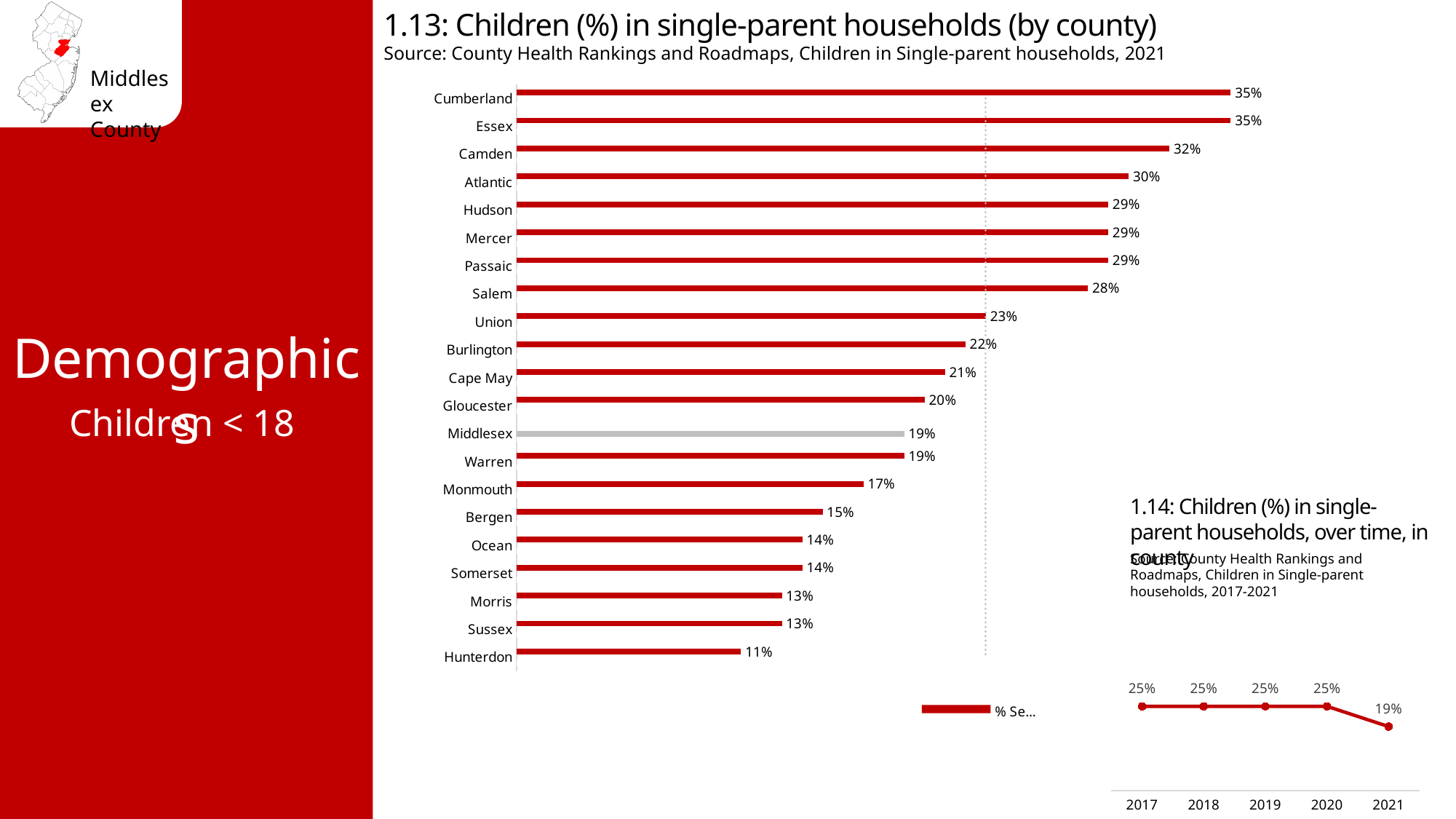
In the chart '1.13: Children (%) in single-parent households (by county)', what is the value for Middlesex? 19% In the chart '1.13: Children (%) in single-parent households (by county)', what is the value for Monmouth? 17% In the chart '1.13: Children (%) in single-parent households (by county)', which is larger, Atlantic or Union? Atlantic In the chart '1.14: Children (%) in single-parent households, over time, in county', what is the value for 2017? 25% In the chart '1.13: Children (%) in single-parent households (by county)', how many counties are shown? 21 In the chart '1.13: Children (%) in single-parent households (by county)', what is the value for Camden? 32% What kind of chart is '1.13: Children (%) in single-parent households (by county)'? bar chart In the chart '1.14: Children (%) in single-parent households, over time, in county', what is the value for 2021? 19% In the chart '1.14: Children (%) in single-parent households, over time, in county', what is the difference between 2020 and 2021? 6% In the chart '1.13: Children (%) in single-parent households (by county)', which county has the lowest value? Hunterdon In the chart '1.14: Children (%) in single-parent households, over time, in county', how many years are plotted? 5 In the chart '1.13: Children (%) in single-parent households (by county)', what is the difference between Cumberland and Hunterdon? 24%